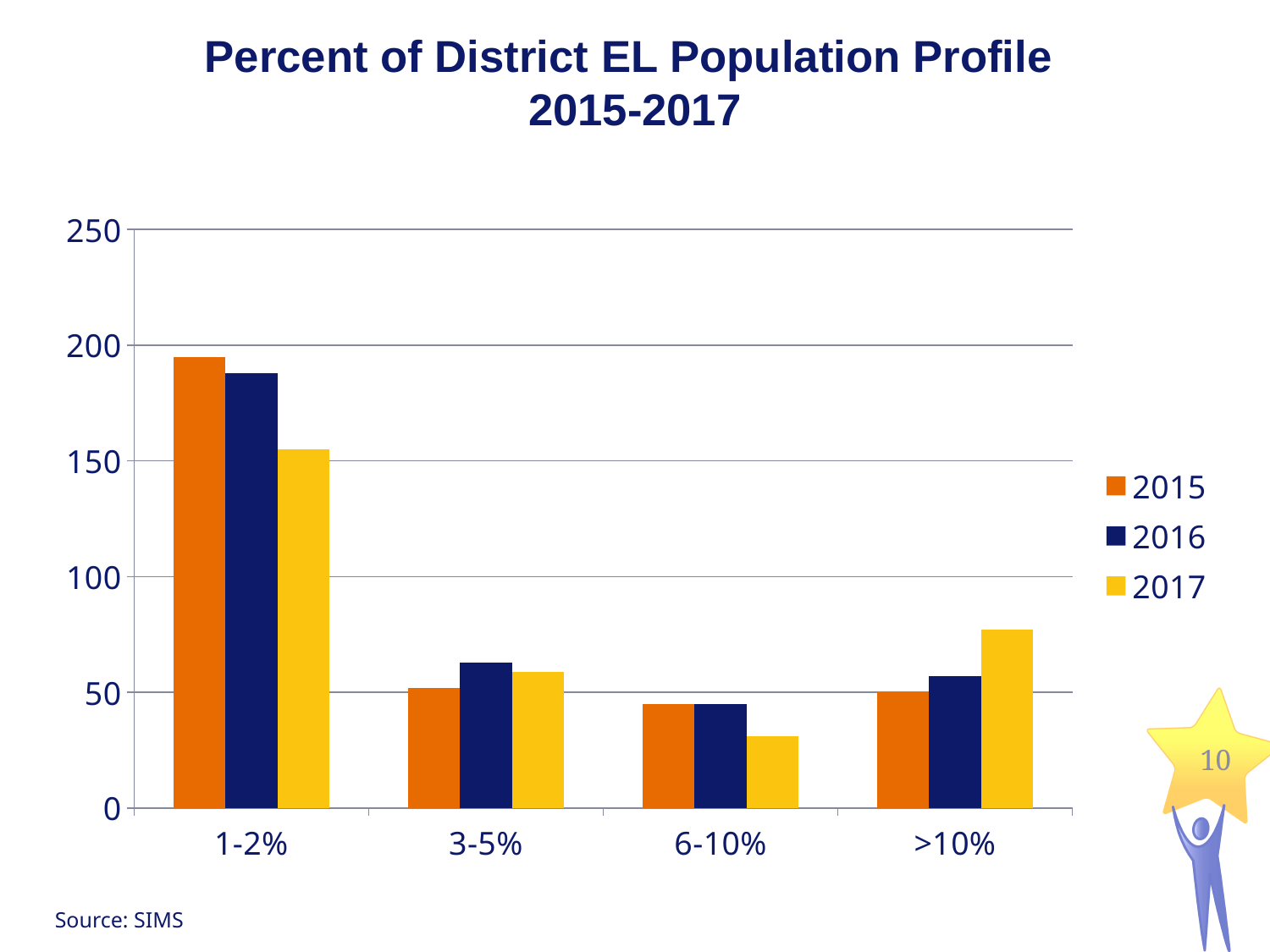
How many categories are shown on the x axis? 4 Is the value for 2017 in the 6-10% category greater or less than 50? less What is the title of the chart? Percent of District EL Population Profile 2015-2017 In the 1-2% category, do the values rise or fall from 2015 to 2017? fall What kind of chart is shown on the slide? Bar chart In the >10% category, which is larger: the value for 2015 or the value for 2017? 2017 Which category has the highest value for 2015? 1-2% Is the value for 2015 in the 1-2% category greater or less than 150? greater In the 1-2% category, which is larger: the value for 2015 or the value for 2017? 2015 How many series does the legend list? 3 Is the value for 2016 in the 3-5% category greater or less than 50? greater Which category has the lowest value for 2017? 6-10%